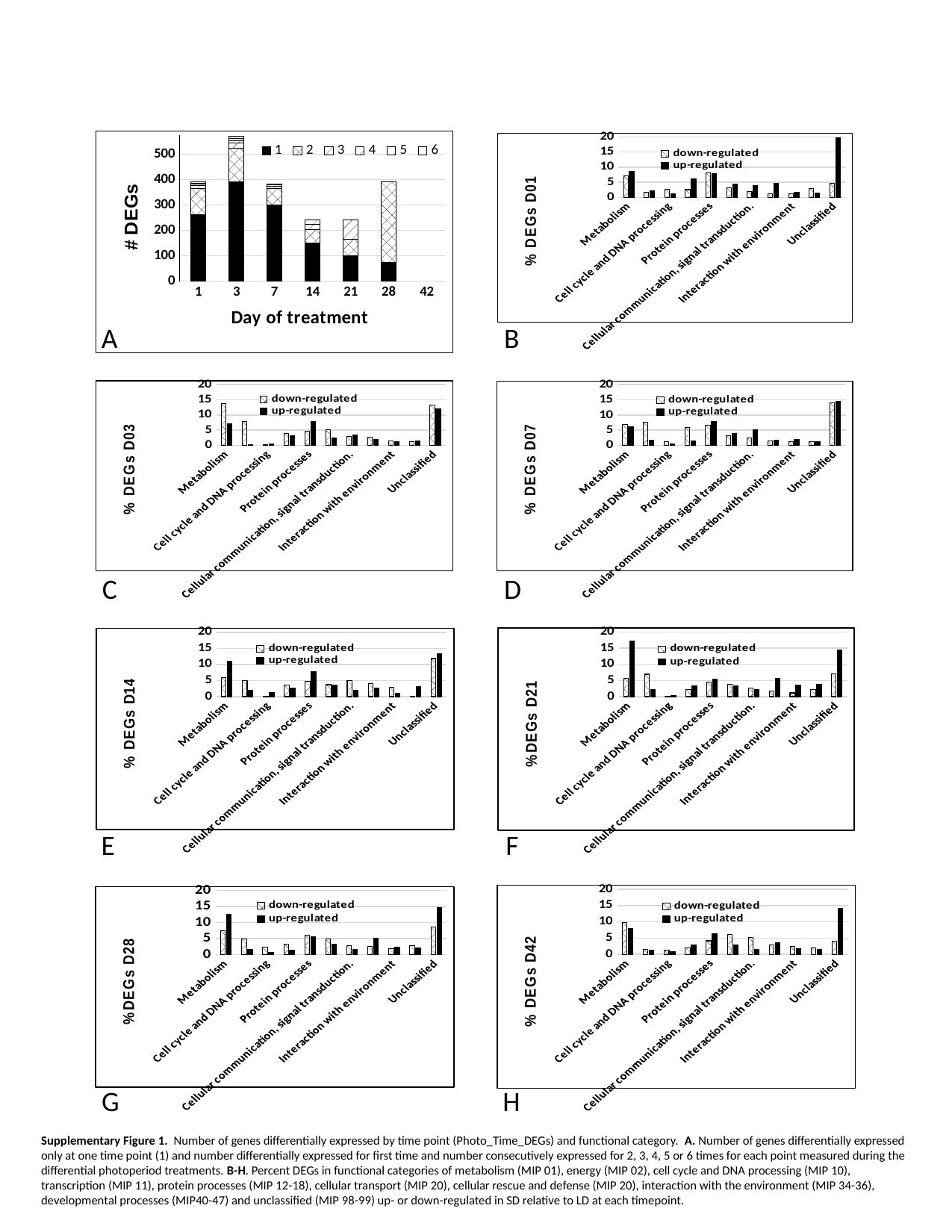
In chart A (# DEGs by day of treatment), how many series does the legend list? 6 In chart A (# DEGs by day of treatment), how many day-of-treatment categories are labelled on the x axis? 7 In chart B (% DEGs D01), how many series does the legend list? 2 In chart A (# DEGs by day of treatment), which day of treatment has the tallest stacked bar? 3 In chart A (# DEGs by day of treatment), is the value of series 1 for day 3 greater or less than 300? greater In chart F (% DEGs D21), which category has the highest up-regulated value? Metabolism In chart E (% DEGs D14), which is larger for Unclassified: the up-regulated value or the down-regulated value? up-regulated What kind of chart is chart A (# DEGs by day of treatment)? stacked bar chart In chart C (% DEGs D03), is the down-regulated value for Metabolism greater or less than 10? greater In chart B (% DEGs D01), is the up-regulated value for Unclassified greater or less than 15? greater